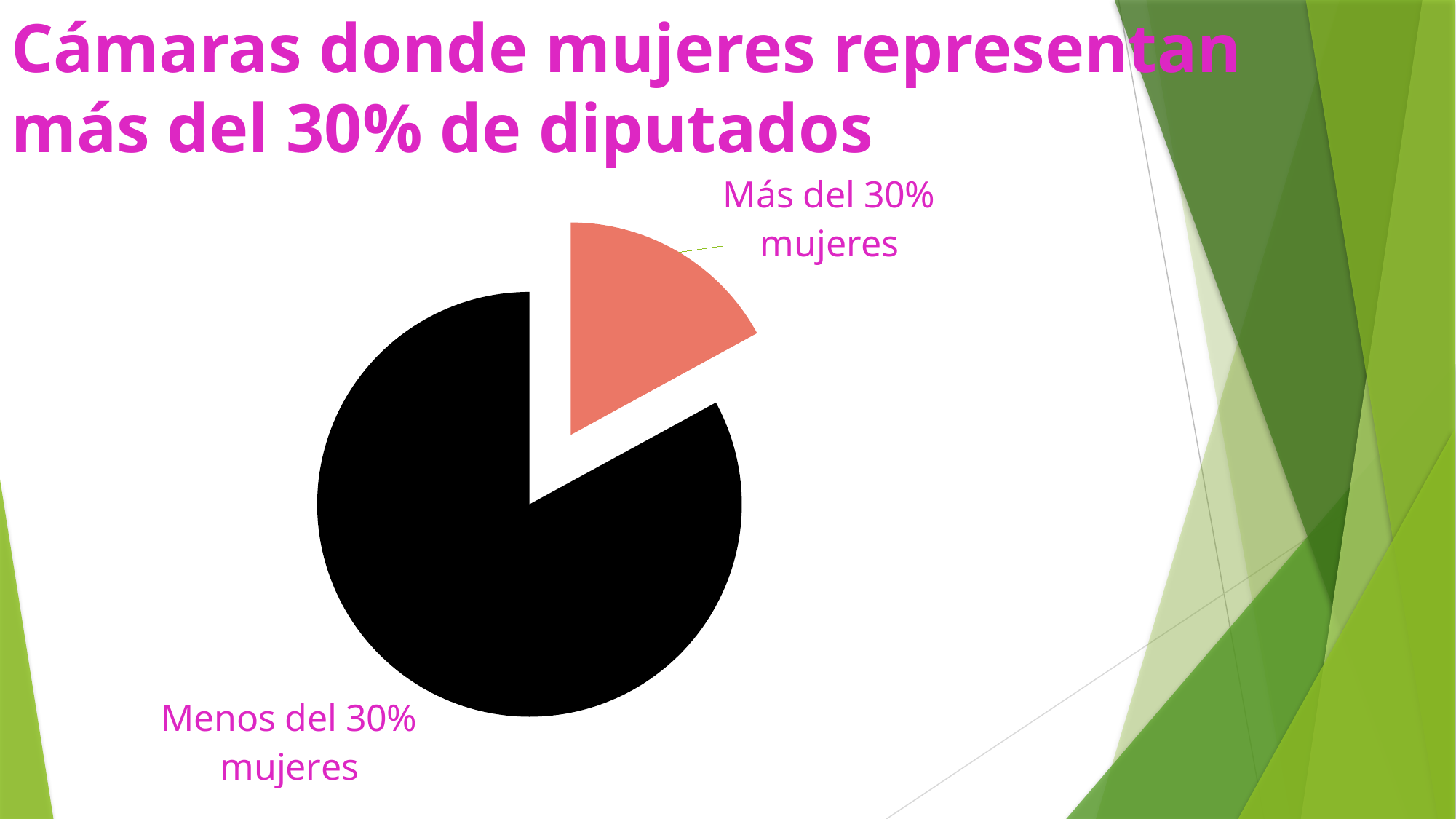
Which slice of the pie chart is the smallest? Más del 30% mujeres What kind of chart is shown on the slide? Pie chart What colour is the "Más del 30% mujeres" slice of the pie chart? Salmon/orange Which slice is larger: "Más del 30% mujeres" or "Menos del 30% mujeres"? Menos del 30% mujeres How many slices does the pie chart have? 2 What is the title of the slide containing the pie chart? Cámaras donde mujeres representan más del 30% de diputados Which slice of the pie chart is the largest? Menos del 30% mujeres